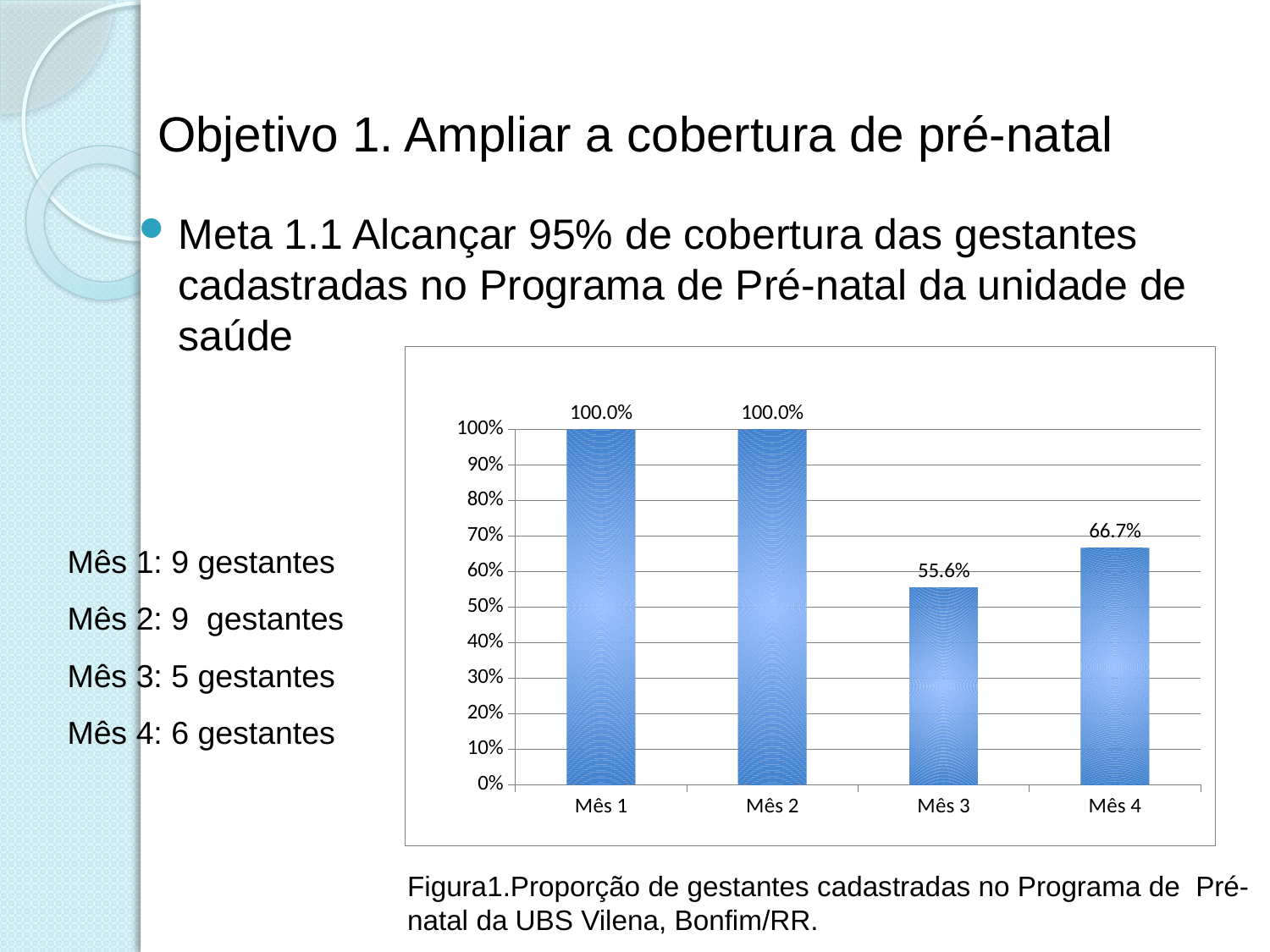
What kind of chart is shown on the slide? bar chart What is the value for Mês 1? 100.0% What is the difference between the values for Mês 4 and Mês 3? 11.1 percentage points Is the value for Mês 3 greater or less than 50%? greater What is the value for Mês 4? 66.7% What is the value for Mês 3? 55.6% Does the value rise or fall from Mês 2 to Mês 3? fall Which months share the highest value? Mês 1 and Mês 2 Which month has the lowest value? Mês 3 Which is larger, the value for Mês 3 or the value for Mês 4? Mês 4 How many months are shown on the x axis? 4 What is the difference between the values for Mês 1 and Mês 3? 44.4 percentage points